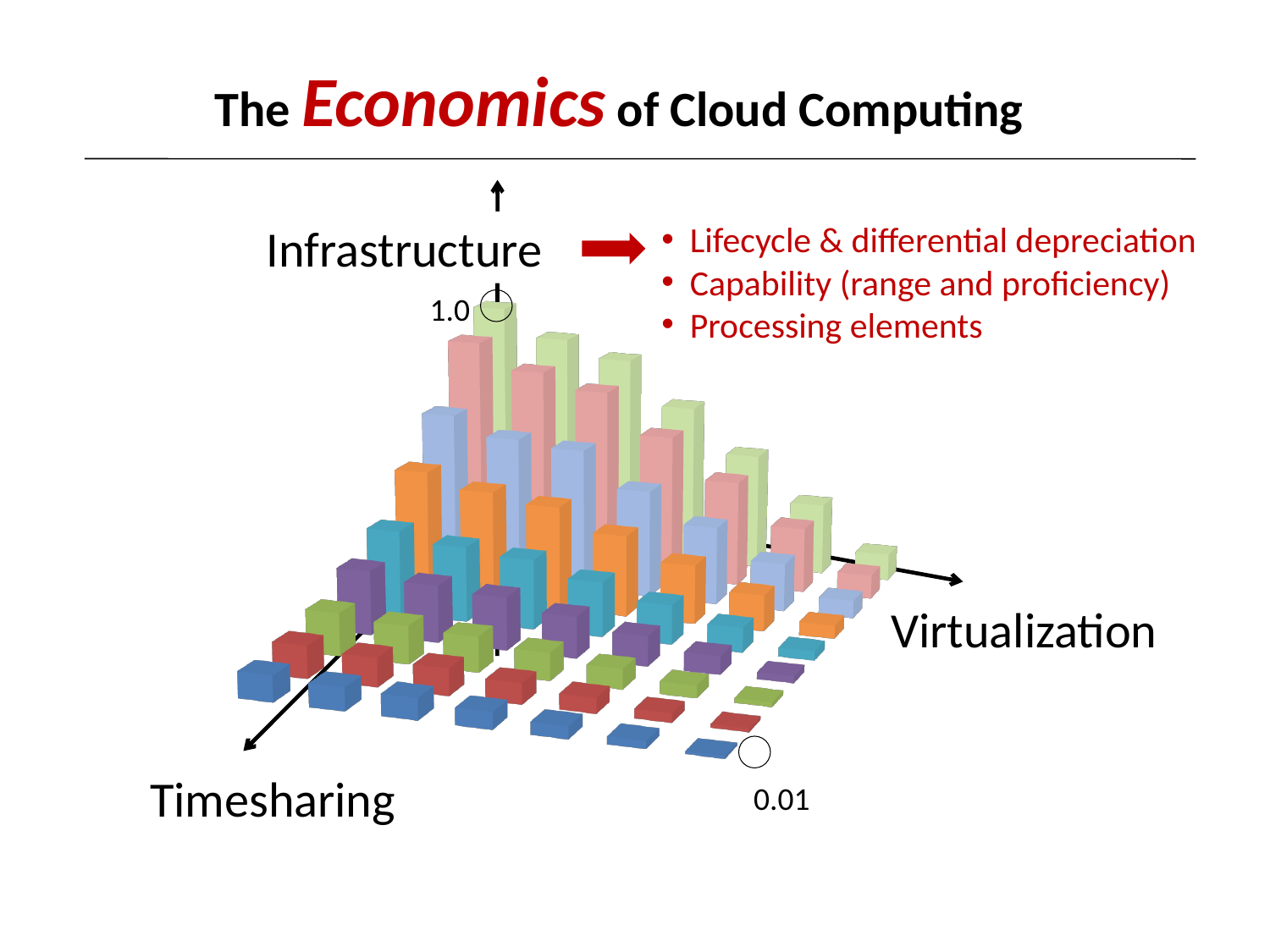
Do the bars rise or fall moving back along the Timesharing axis from the front (blue) row to the back (light green) row? rise What kind of chart is shown on the slide? bar chart Do the bars rise or fall moving along the Virtualization axis from left to right? fall Which colour of bars is the shortest in every row? blue What is the value marked at the top of the vertical axis? 1.0 What is the value marked at the bottom front corner of the chart? 0.01 What label is on the vertical axis of the chart? Infrastructure Which colour of bars is the tallest in every row? light green Is the tallest bar in the chart closer to 1.0 or to 0.01? 1.0 What are the two horizontal axes of the chart labelled? Timesharing and Virtualization